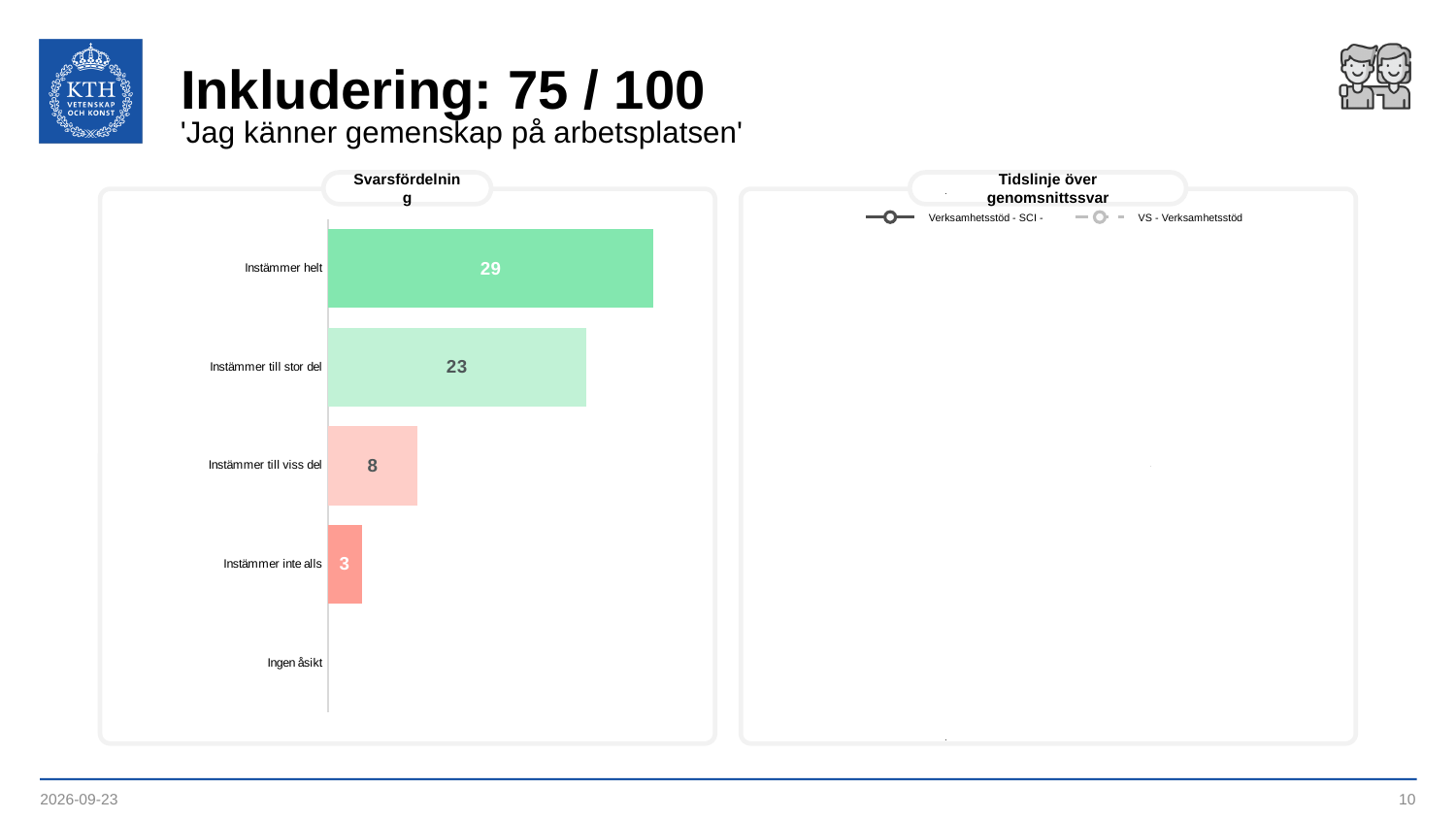
In the 'Svarsfördelning' chart, which is larger: the value for 'Instämmer till stor del' or the value for 'Instämmer till viss del'? Instämmer till stor del How many categories are listed on the axis of the 'Svarsfördelning' chart? 5 In the 'Svarsfördelning' chart, what is the value for 'Instämmer inte alls'? 3 How many series does the legend of the 'Tidslinje över genomsnittssvar' chart list? 2 In the 'Svarsfördelning' chart, which category with a labelled bar has the lowest value? Instämmer inte alls In the 'Svarsfördelning' chart, which category with a labelled bar has the highest value? Instämmer helt In the 'Svarsfördelning' chart, what is the value for 'Instämmer till stor del'? 23 In the 'Svarsfördelning' chart, what is the difference between the values for 'Instämmer till viss del' and 'Instämmer inte alls'? 5 In the 'Svarsfördelning' chart, what is the value for 'Instämmer helt'? 29 In the 'Svarsfördelning' chart, what is the value for 'Instämmer till viss del'? 8 In the 'Svarsfördelning' chart, what is the difference between the values for 'Instämmer helt' and 'Instämmer till stor del'? 6 What kind of chart is the 'Svarsfördelning' chart? Bar chart